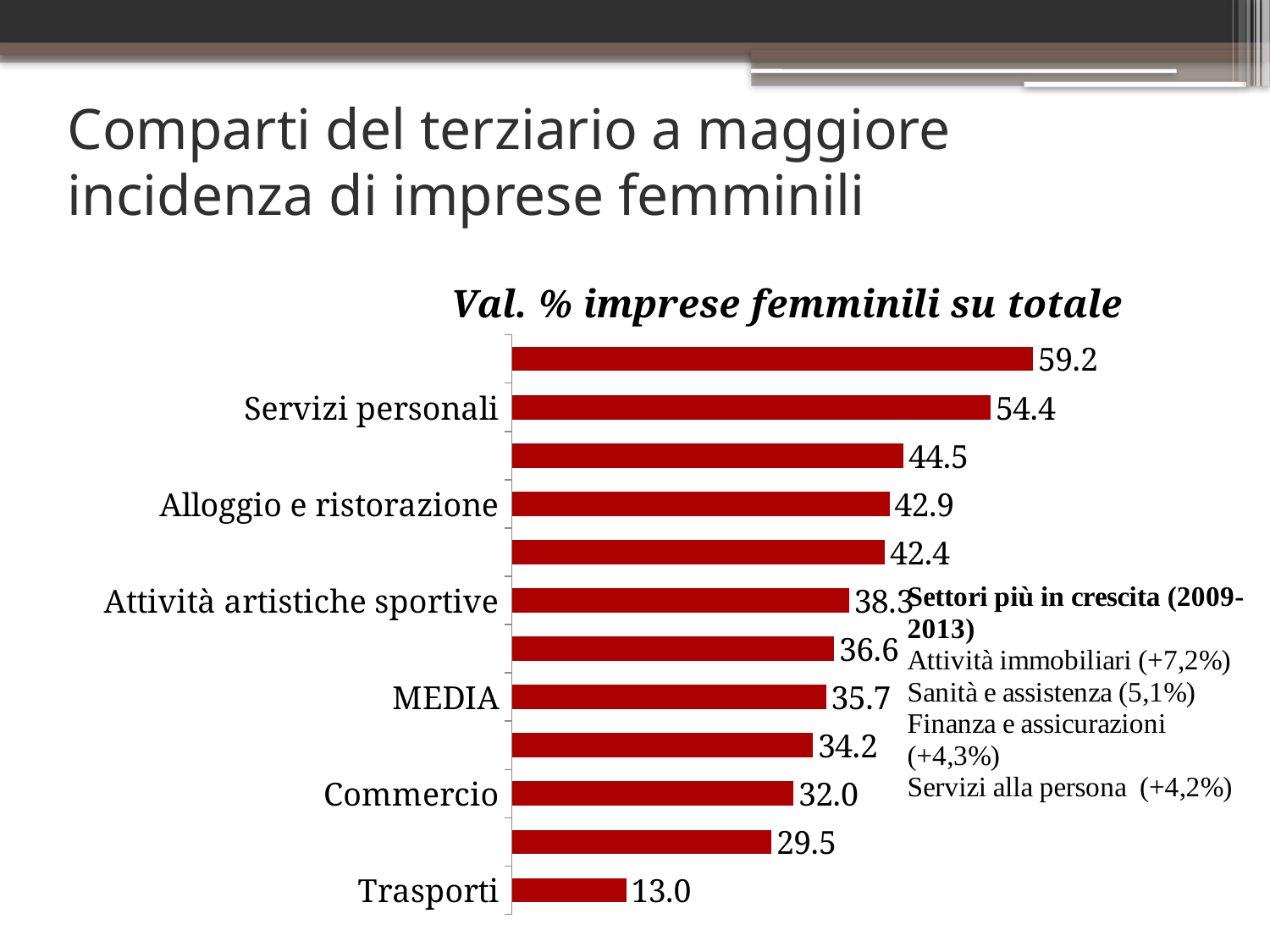
What is the value for Trasporti? 13.0 How many bars are plotted on the chart? 12 What is the value for Commercio? 32.0 Which is larger, the value for Alloggio e ristorazione or the value for MEDIA? Alloggio e ristorazione What kind of chart is shown? Bar chart Which labelled category has the lowest value? Trasporti What is the highest value shown on the chart? 59.2 What is the value for Servizi personali? 54.4 What is the difference between the values for Servizi personali and Trasporti? 41.4 What is the value for MEDIA? 35.7 What is the value for Alloggio e ristorazione? 42.9 What is the difference between the values for Servizi personali and Commercio? 22.4